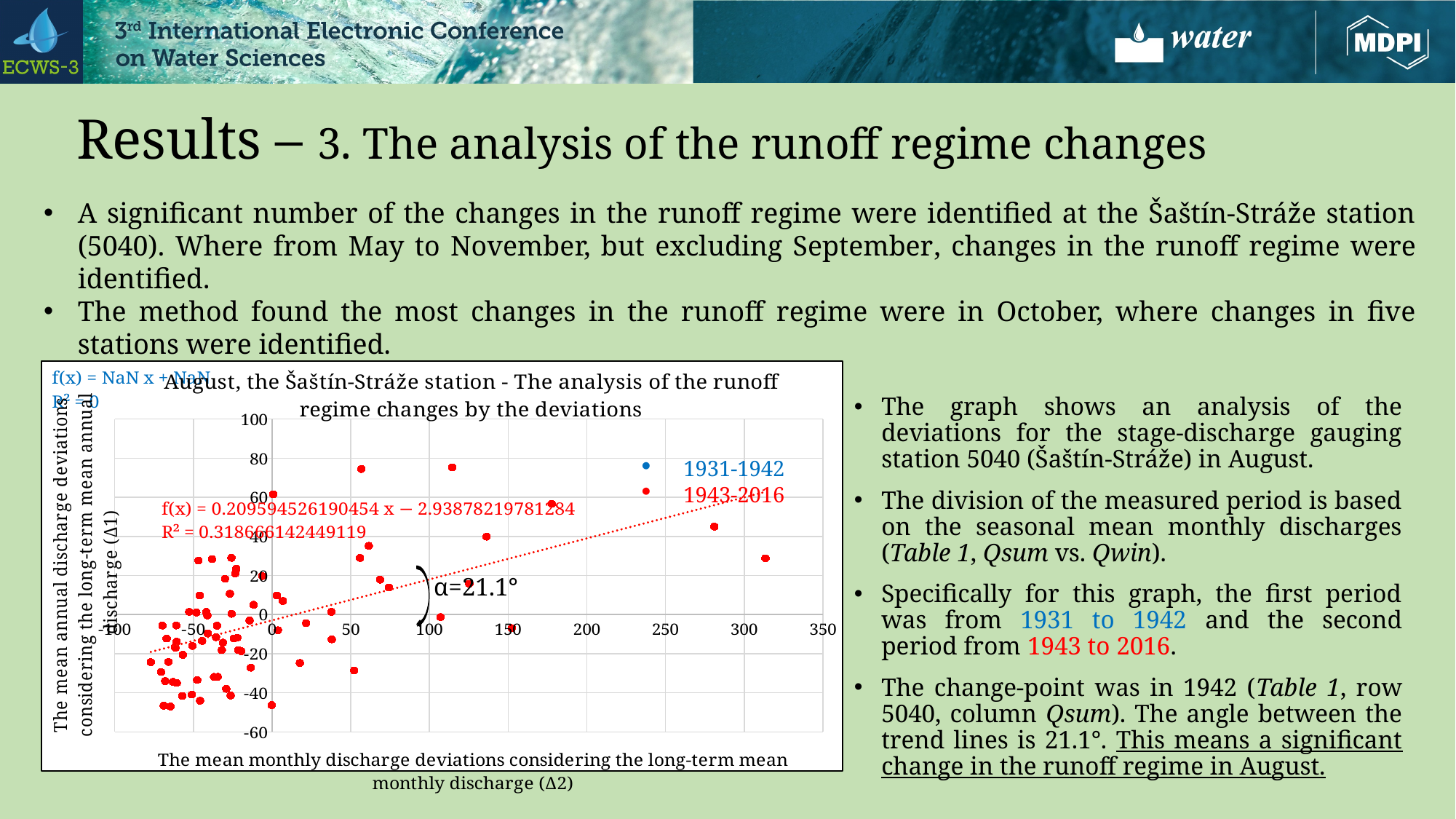
What angle α is annotated on the chart? α=21.1° What kind of chart is shown on the slide? Scatter chart Is the highest plotted y value on the chart greater or less than 60? greater Which colour represents the 1943-2016 series in the chart? Red What are the two periods listed in the chart legend? 1931-1942 and 1943-2016 How many series does the chart legend list? 2 Is the y value of the rightmost plotted point (near x = 315) greater or less than 0? greater What is the maximum value shown on the chart's x axis? 350 Does the dotted red trend line rise or fall as the x value increases? Rises Is the lowest plotted y value on the chart greater or less than -20? less What is the slope coefficient in the trend line equation printed on the chart? 0.209594526190454 What is the R² value printed for the red trend line on the chart? 0.318666142449119